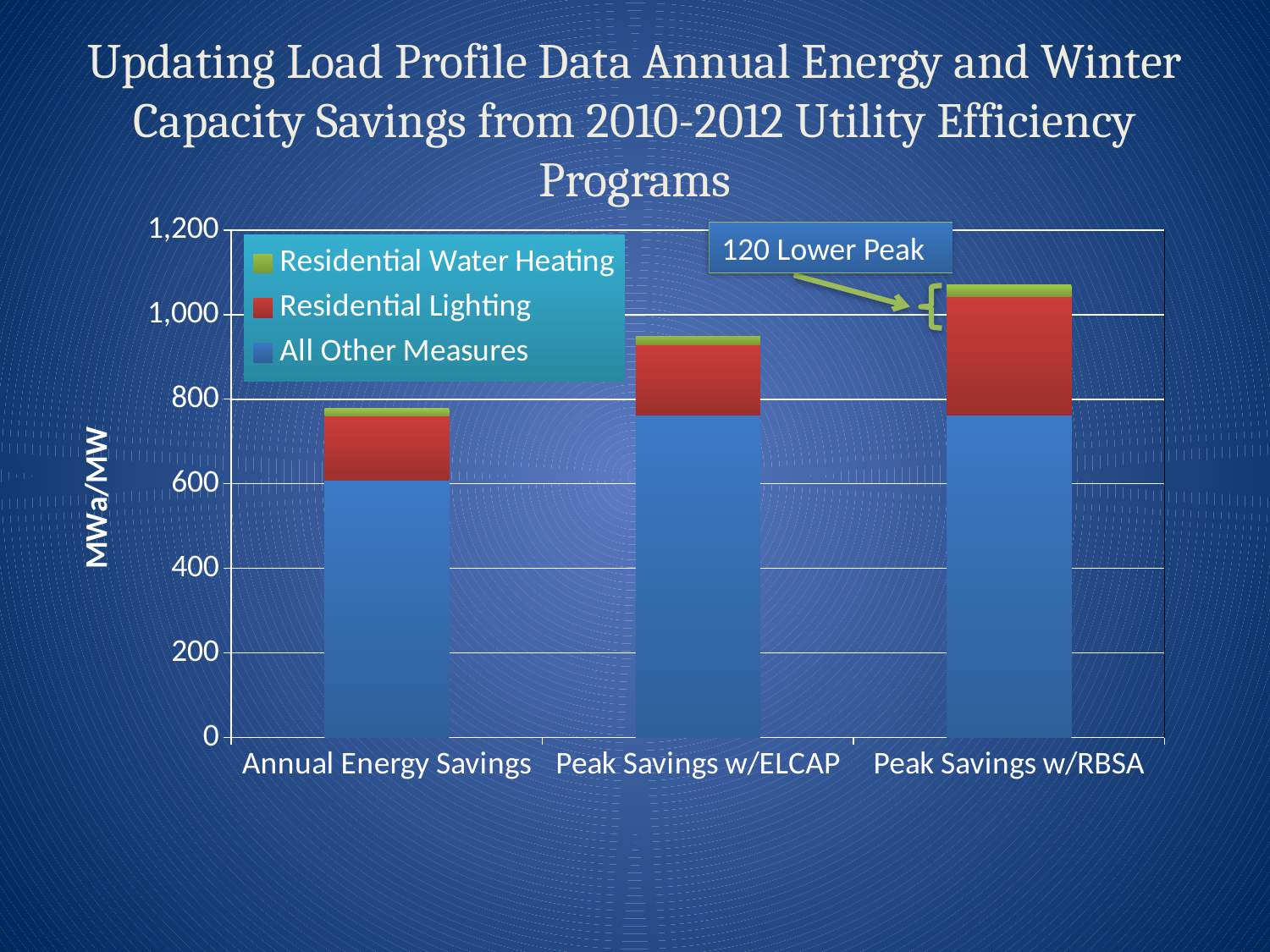
Is the total stacked value for Peak Savings w/ELCAP greater or less than 1,000? less Is the total stacked value for Annual Energy Savings greater or less than 800? less How many series does the chart's legend list? 3 Which category has the tallest stacked bar? Peak Savings w/RBSA What kind of chart is shown on the slide? Stacked bar chart What is the label on the chart's vertical axis? MWa/MW Which category has the shortest stacked bar? Annual Energy Savings Which is larger, the total stacked bar for Peak Savings w/ELCAP or for Annual Energy Savings? Peak Savings w/ELCAP How many categories are shown on the x axis of the chart? 3 What does the callout box above the Peak Savings w/RBSA bar say? 120 Lower Peak Is the total stacked value for Peak Savings w/RBSA greater or less than 1,000? greater